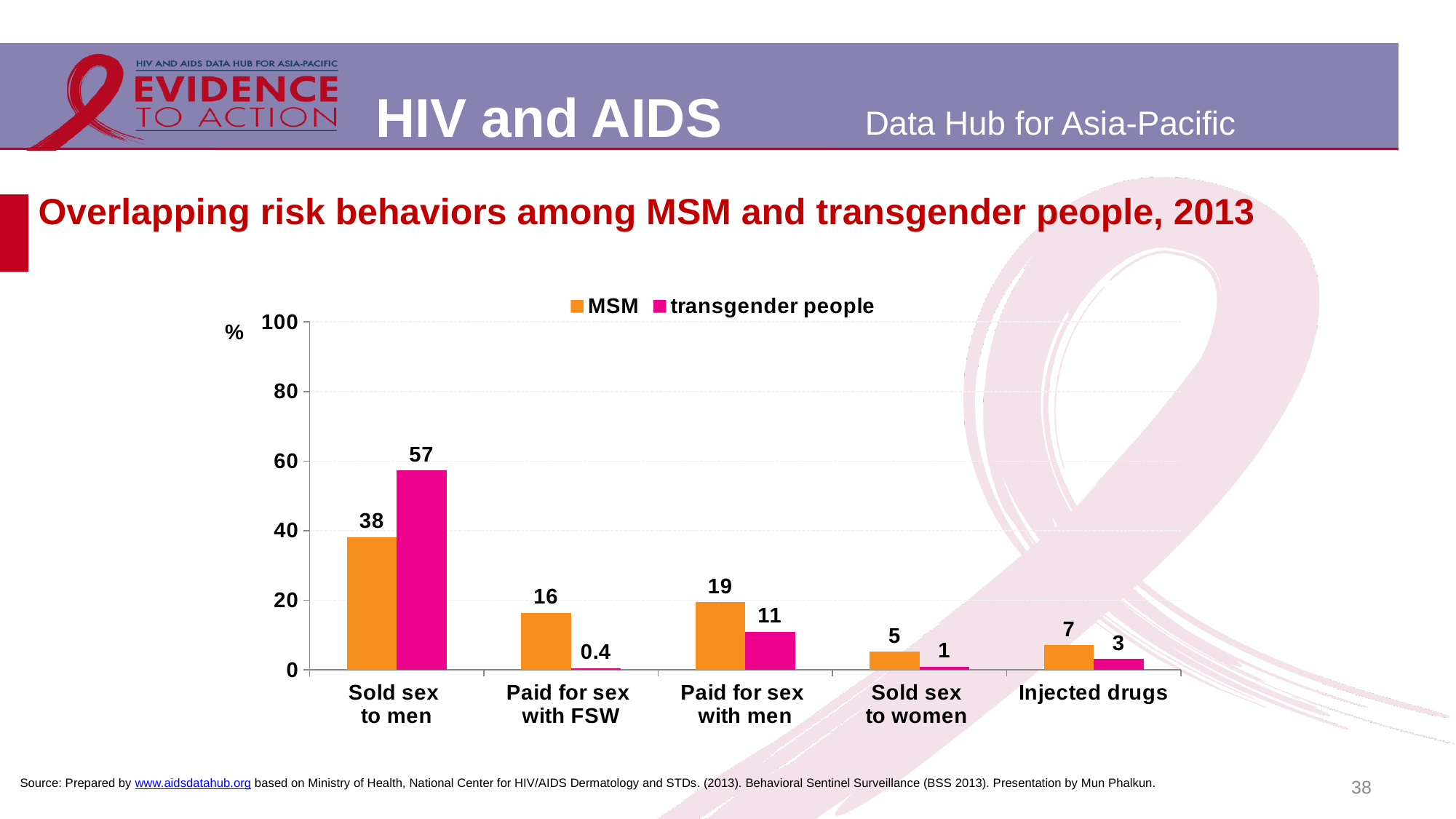
Which category has the highest value for transgender people? Sold sex to men How many categories are shown on the x axis? 5 How many series does the legend list? 2 Which category has the lowest value for MSM? Sold sex to women What kind of chart is shown on the slide? Bar chart What colour represents transgender people in the chart? Pink What is the difference between the transgender people and MSM values in the 'Sold sex to men' category? 19 What is the value for transgender people in the 'Injected drugs' category? 3 Is the value for transgender people in 'Sold sex to men' greater or less than 40? greater In the 'Paid for sex with men' category, which series has the larger value, MSM or transgender people? MSM What is the value for transgender people in the 'Paid for sex with FSW' category? 0.4 What is the value for MSM in the 'Sold sex to men' category? 38